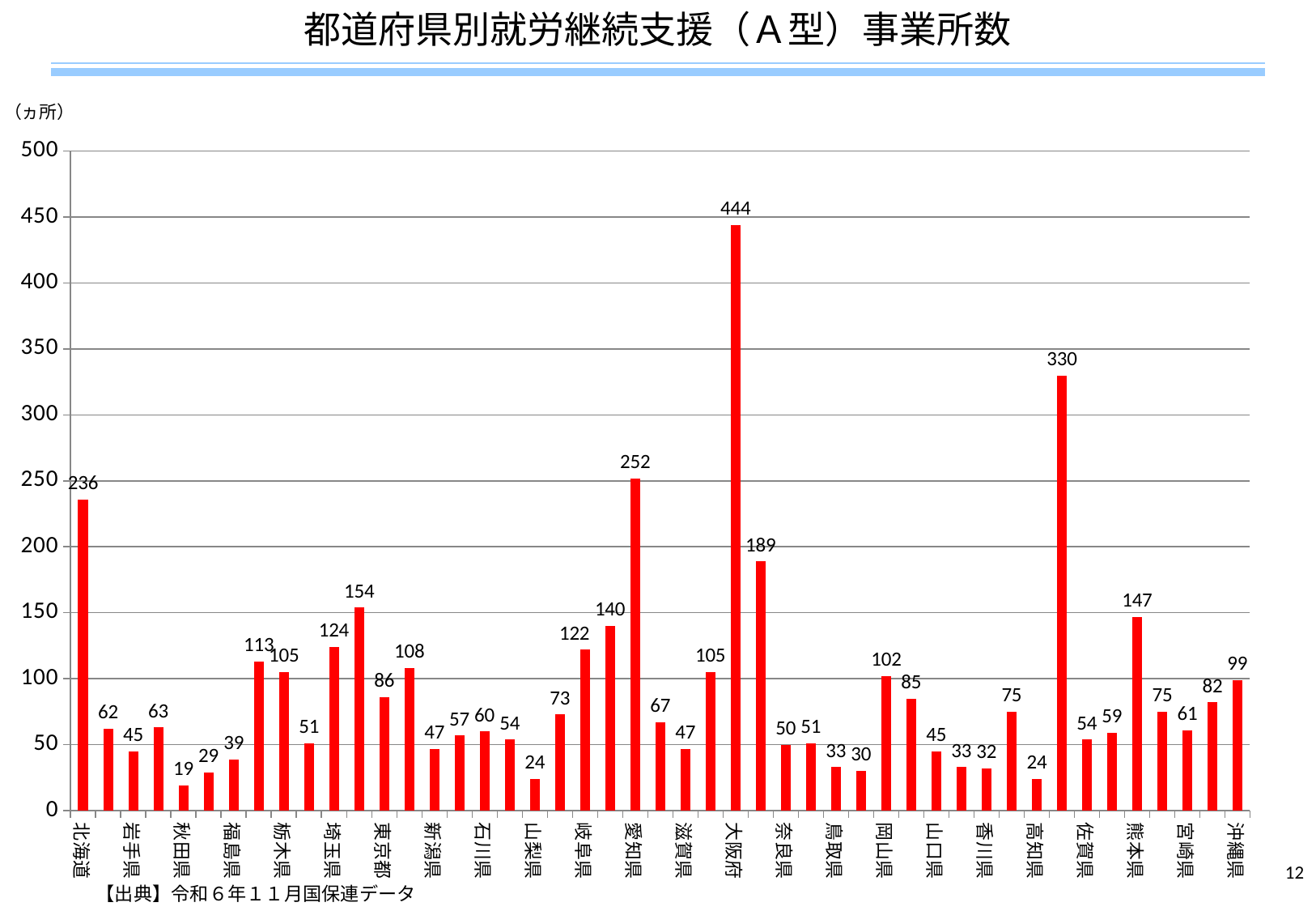
What is the value for 熊本県? 147 Is the value for 岐阜県 greater or less than 100? greater What is the difference between the values for 大阪府 and 愛知県? 192 What is the value for 北海道? 236 What kind of chart is shown on the slide? bar chart What is the value for 大阪府? 444 What is the value for 愛知県? 252 Which labeled prefecture has the lowest value? 秋田県 Which is larger, the value for 北海道 or the value for 愛知県? 愛知県 Which prefecture has the highest value? 大阪府 What is the value for 沖縄県? 99 What is the title of the chart? 都道府県別就労継続支援（Ａ型）事業所数